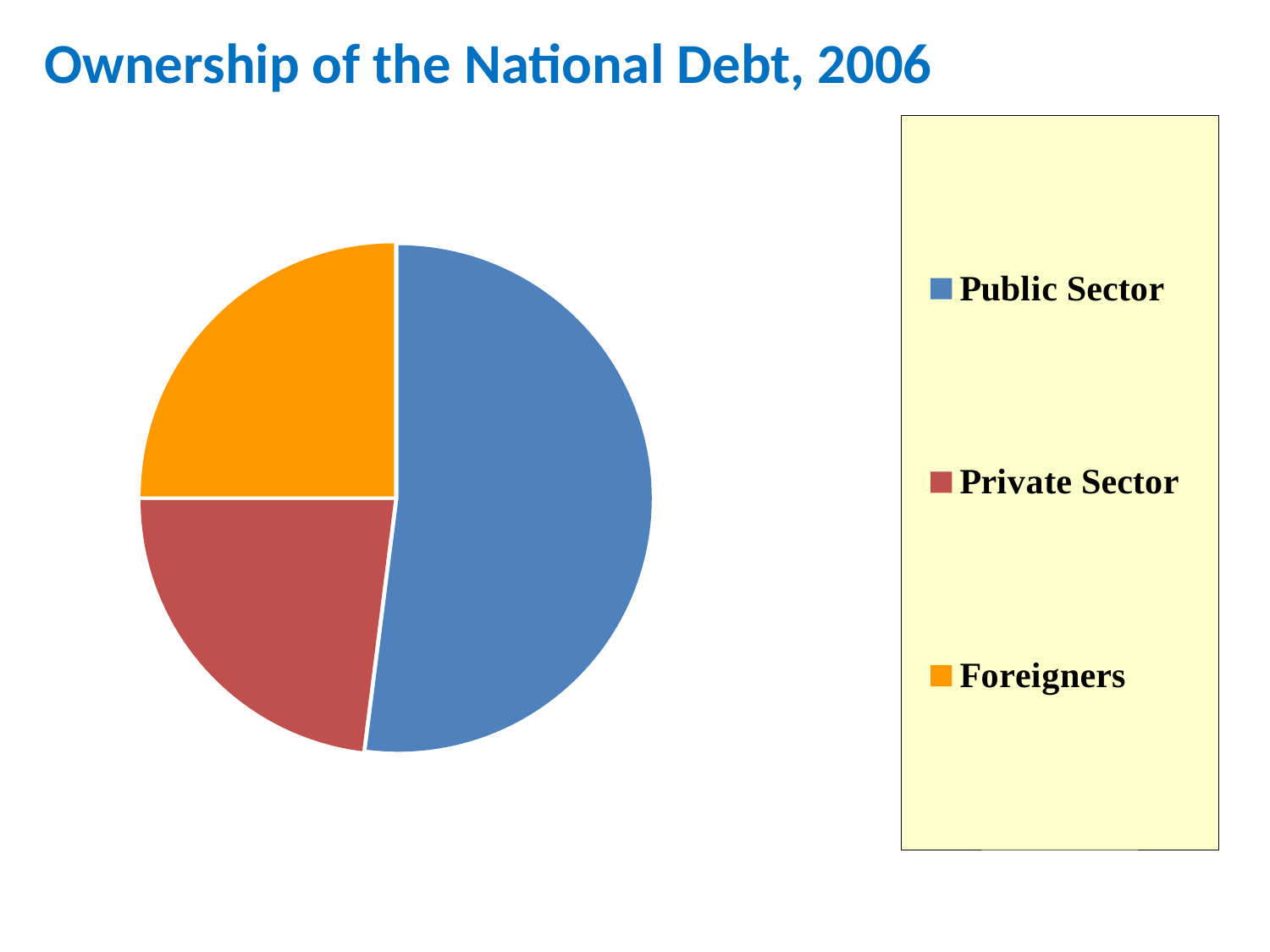
What is the title of the slide's chart? Ownership of the National Debt, 2006 Which colour represents Foreigners in the pie chart? orange Which category holds the largest share of the national debt in the pie chart? Public Sector What kind of chart is shown on the slide? pie chart How many slices does the pie chart have? 3 Which slice is larger, Public Sector or Foreigners? Public Sector Which slice is larger, Public Sector or Private Sector? Public Sector How many entries does the legend list? 3